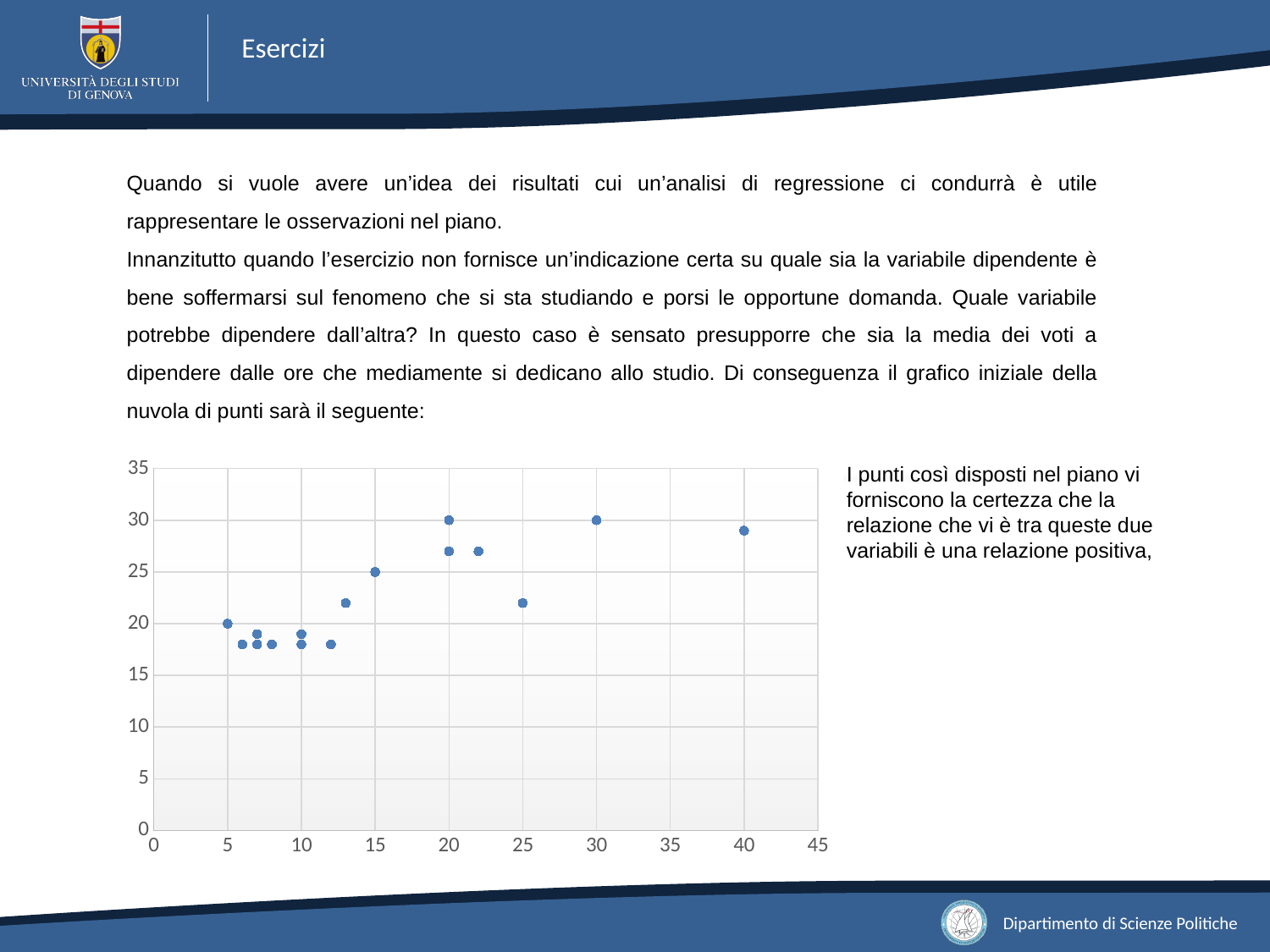
Which point has the higher y value: the one at x = 15 or the one at x = 25? The one at x = 15 Is the y value of the point at x = 22 greater or less than 25? greater How many points are plotted on the chart? 16 What is the highest value shown on the y axis? 35 Is the y value of the point at x = 40 greater or less than 25? greater Is the y value of the point at x = 25 greater or less than 25? less Do the plotted values generally rise or fall as the x value increases? Rise What is the highest value shown on the x axis? 45 Which point has the largest x value: the one at x = 30 or the one at x = 40? The one at x = 40 What kind of chart is shown on the slide? Scatter plot